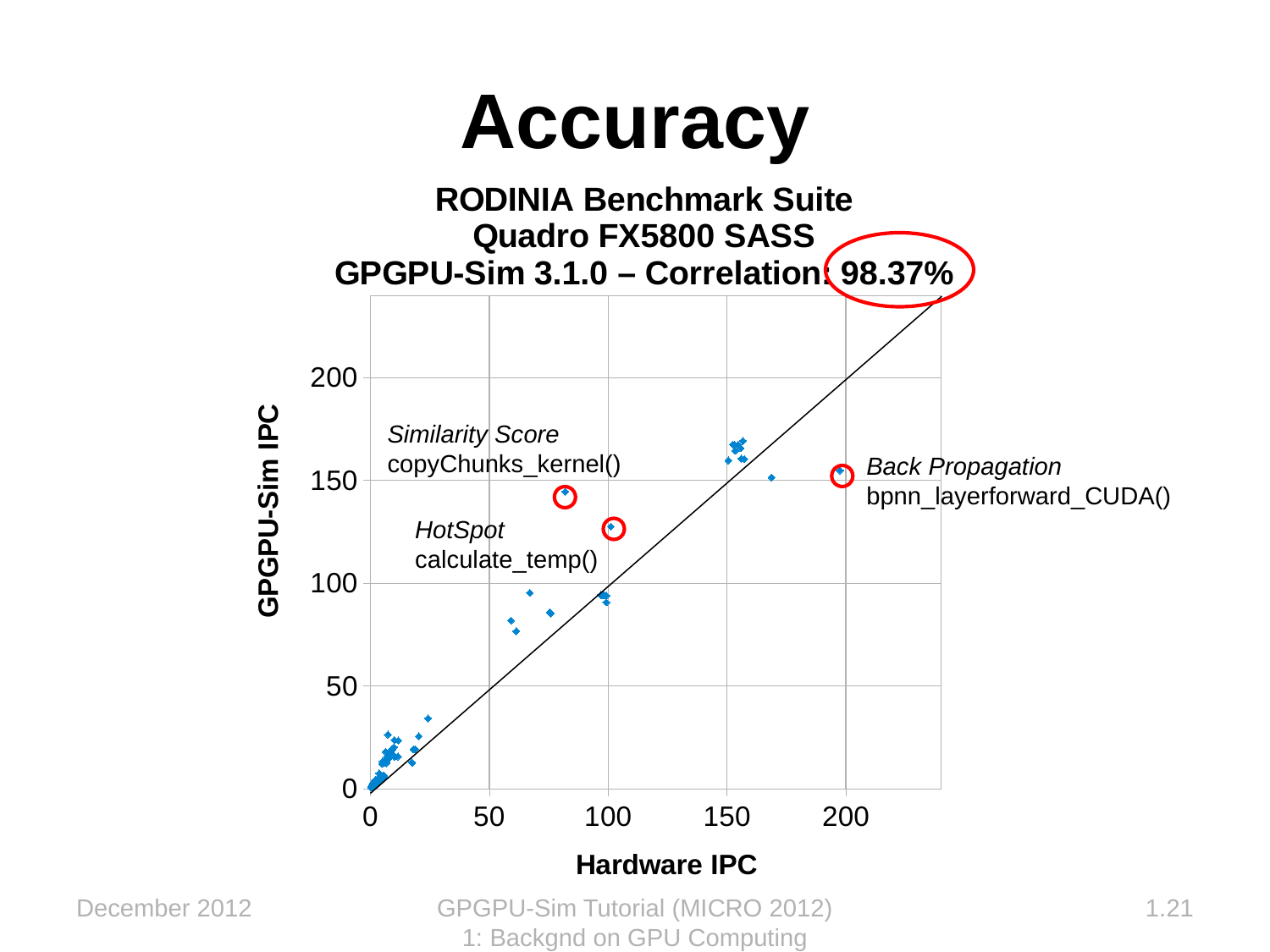
Is the Hardware IPC value for the Similarity Score copyChunks_kernel() point greater or less than 100? less Which of the two annotated points has the larger GPGPU-Sim IPC: Similarity Score copyChunks_kernel() or HotSpot calculate_temp()? Similarity Score copyChunks_kernel() What is the label of the horizontal axis of the chart? Hardware IPC Is the GPGPU-Sim IPC value for the Back Propagation bpnn_layerforward_CUDA() point greater or less than 200? less What correlation value is stated in the chart title? 98.37% Is the GPGPU-Sim IPC value for the Similarity Score copyChunks_kernel() point greater or less than 100? greater How many points on the chart are circled in red and labelled with a benchmark name? 3 What kind of chart is shown on the slide? scatter plot Which of the two annotated points has the larger Hardware IPC: HotSpot calculate_temp() or Back Propagation bpnn_layerforward_CUDA()? Back Propagation bpnn_layerforward_CUDA()